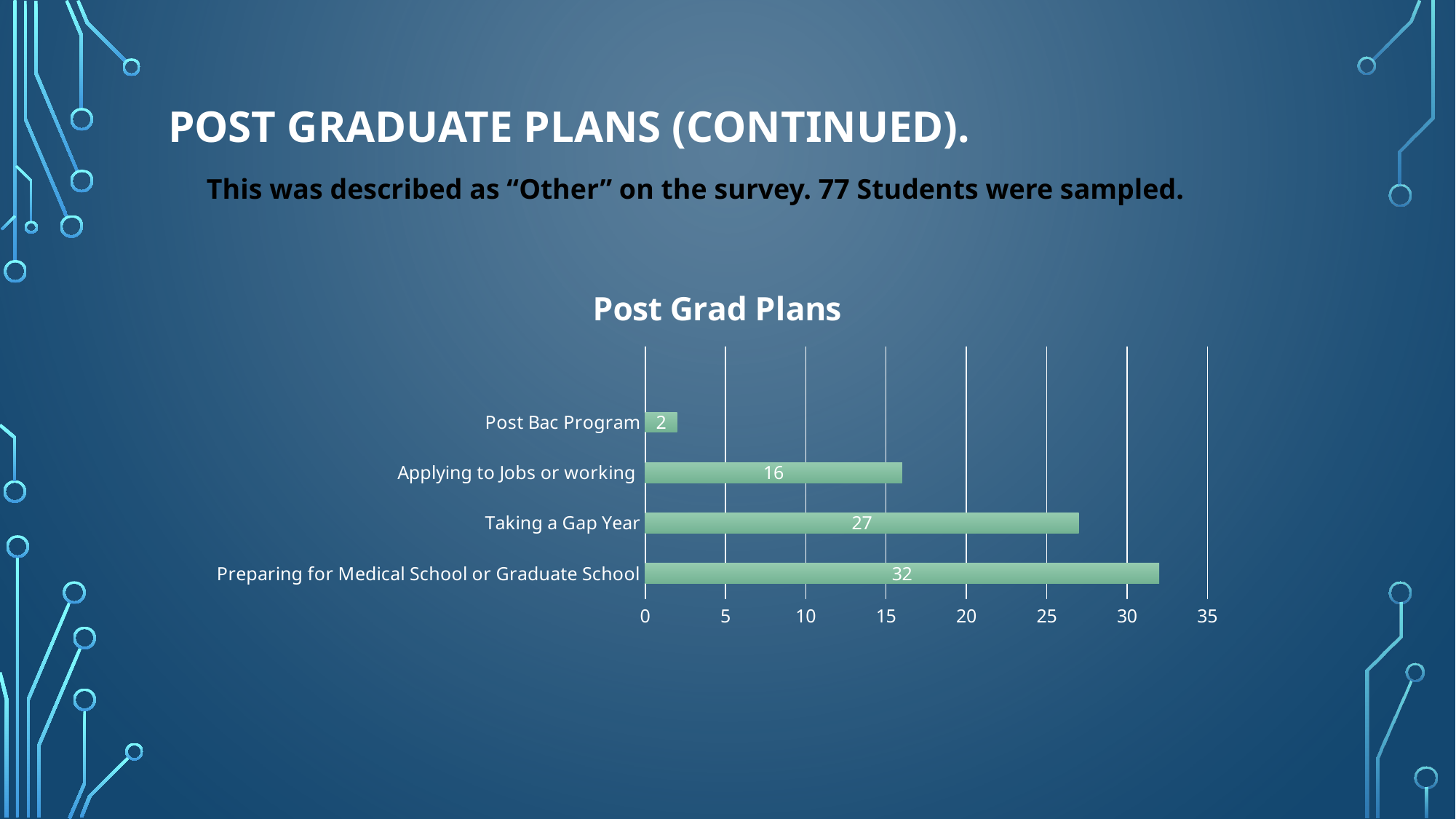
Which is larger, the value for Taking a Gap Year or the value for Applying to Jobs or working? Taking a Gap Year What is the value for Preparing for Medical School or Graduate School? 32 What is the value for Taking a Gap Year? 27 What is the value for Post Bac Program? 2 What is the title of the chart? Post Grad Plans Which category has the highest value? Preparing for Medical School or Graduate School Is the value for Applying to Jobs or working greater or less than 20? less How many categories are shown in the chart? 4 What kind of chart is shown on the slide? bar chart What is the value for Applying to Jobs or working? 16 Which category has the lowest value? Post Bac Program What is the difference between the values for Preparing for Medical School or Graduate School and Taking a Gap Year? 5